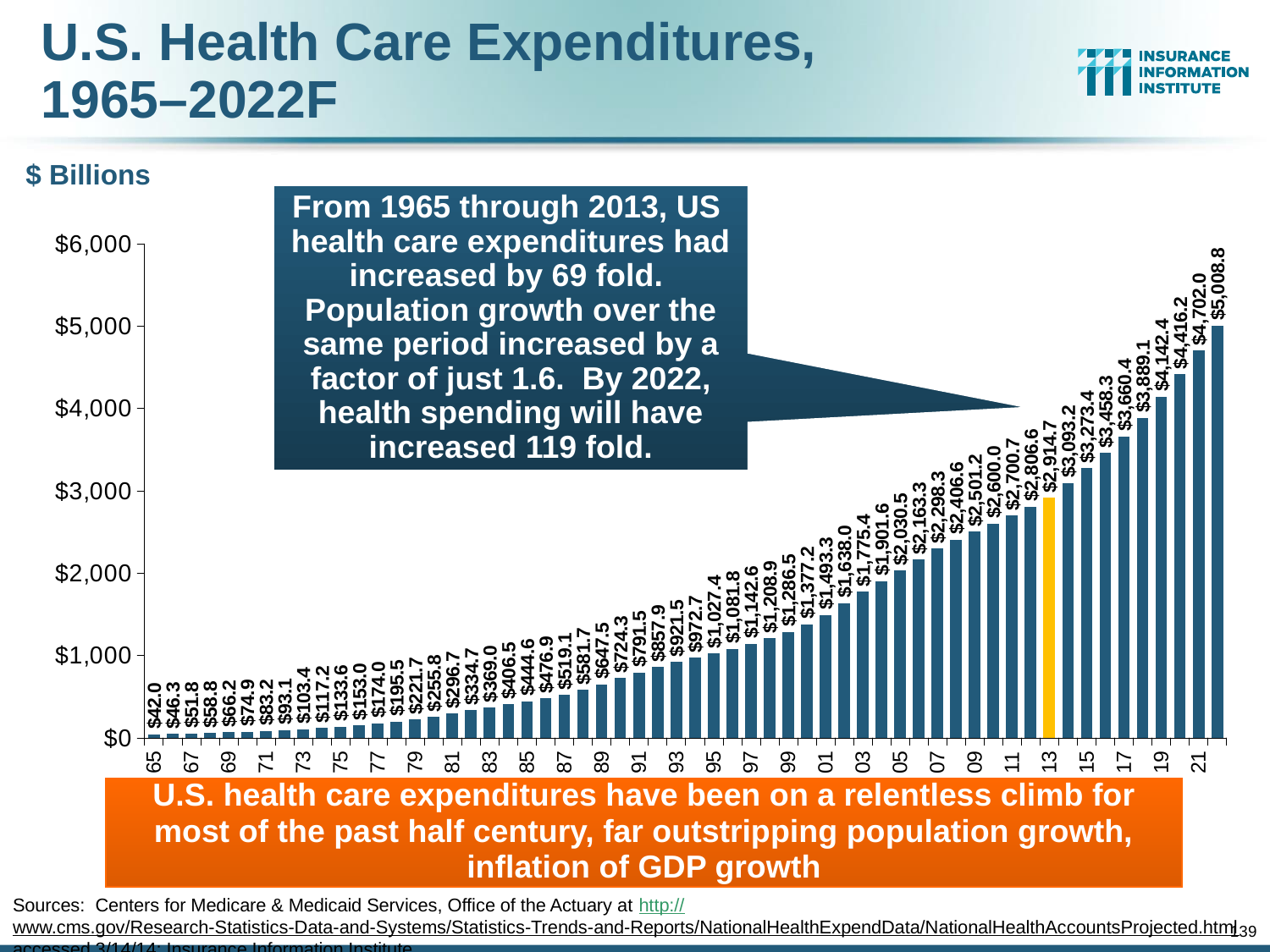
What value is shown for 1985? $444.6 Is the value for 2009 greater or less than $2,000? greater Which year has the lowest expenditure on the chart? 1965 What is the forecast value for 2022 on the chart? $5,008.8 Do the values generally rise or fall from left to right along the x axis? rise Which is larger, the value for 2005 or the value for 2001? 2005 What is the value shown for 2013, the highlighted bar? $2,914.7 Which year's bar is highlighted in a different colour from the rest? 2013 What was U.S. health care expenditure in 1965 according to the chart? $42.0 What is the difference between the 2022 value and the 2013 value? $2,094.1 Which year has the highest expenditure on the chart? 2022 What type of chart is shown on the slide? bar chart